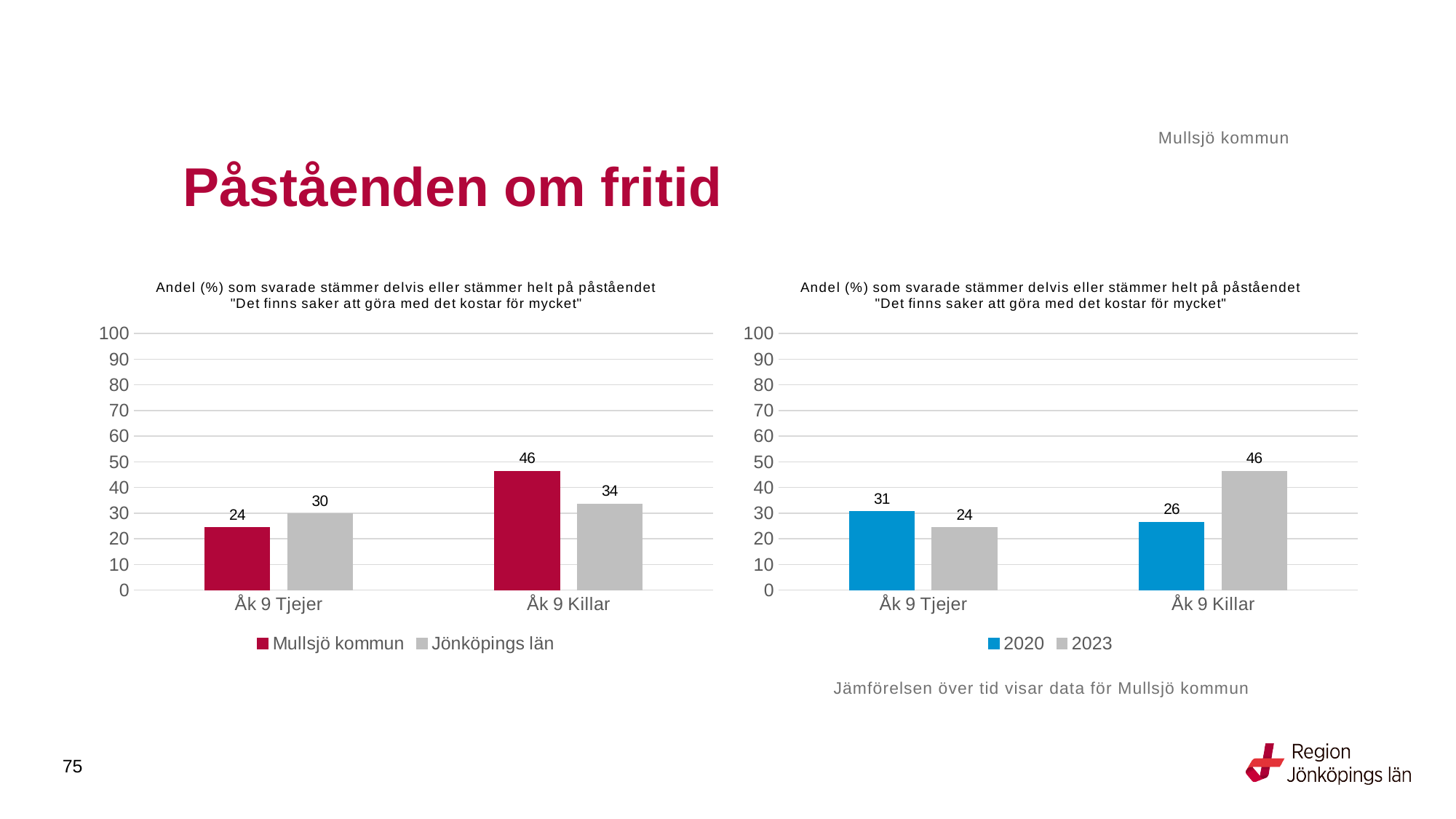
In the left chart, what is the difference between Mullsjö kommun and Jönköpings län for Åk 9 Killar? 12 In the right chart, what is the value for 2023 for Åk 9 Killar? 46 In the left chart, which category has the highest value for Mullsjö kommun? Åk 9 Killar How many series does the legend of the right chart list? 2 In the right chart, which is larger for Åk 9 Tjejer: 2020 or 2023? 2020 In the right chart, which category has the lowest value for 2023? Åk 9 Tjejer What kind of chart is the left chart? Bar chart In the right chart, what is the value for 2020 for Åk 9 Tjejer? 31 In the left chart, which is larger for Åk 9 Tjejer: Mullsjö kommun or Jönköpings län? Jönköpings län In the left chart, what is the value for Mullsjö kommun for Åk 9 Tjejer? 24 In the right chart, what is the difference between 2023 and 2020 for Åk 9 Killar? 20 In the left chart, what is the value for Jönköpings län for Åk 9 Killar? 34